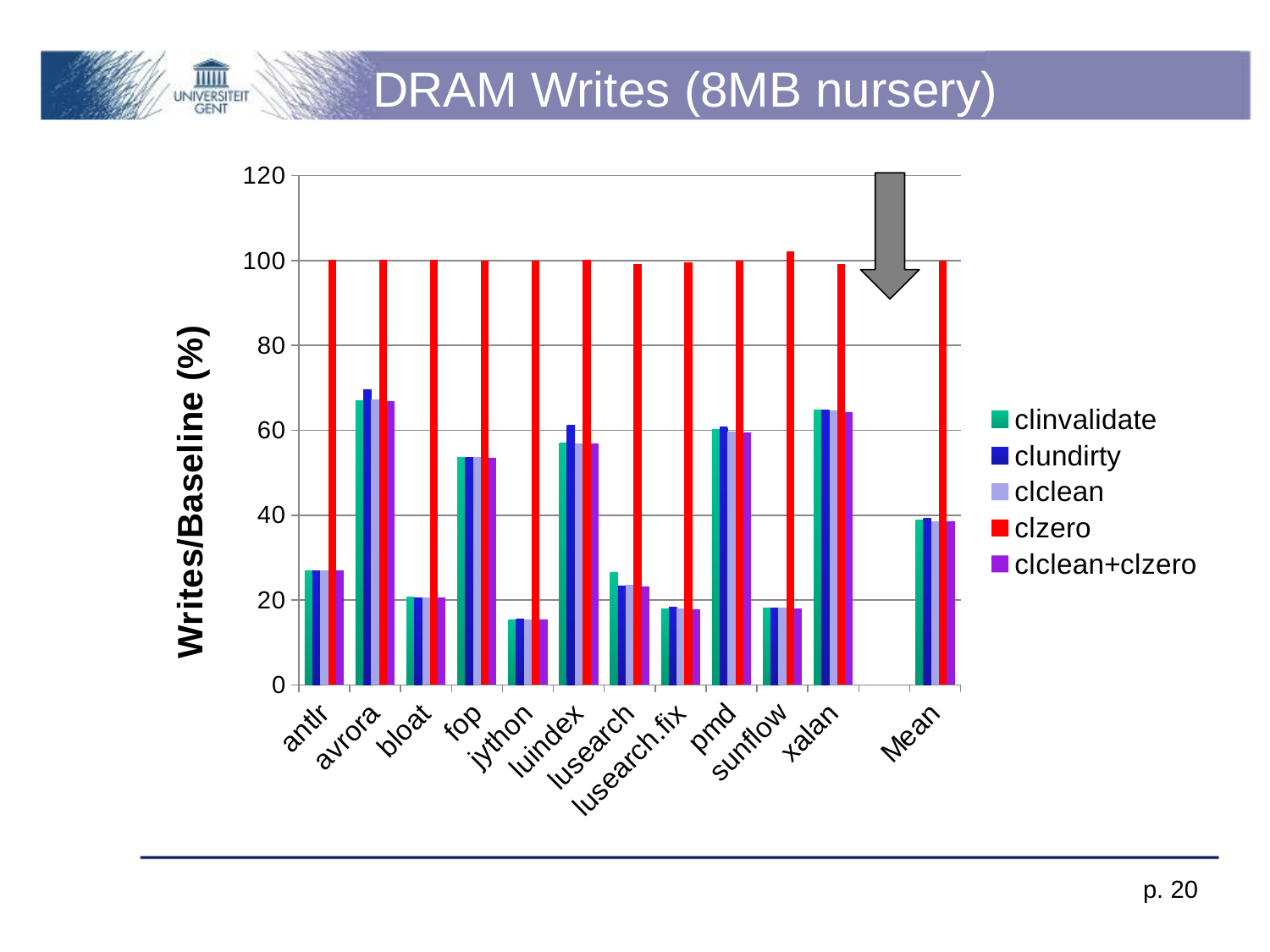
Which is larger, the clinvalidate value for avrora or for bloat? avrora What is the title of the chart? DRAM Writes (8MB nursery) What kind of chart is shown on the slide? bar chart How many series does the legend list? 5 Is the clinvalidate value for jython greater or less than 20? less How many categories are shown along the x axis? 12 Which category has the lowest clinvalidate value? jython Is the clinvalidate value for lusearch greater or less than 40? less Is the clinvalidate value for avrora greater or less than 60? greater What is the label on the y axis? Writes/Baseline (%)